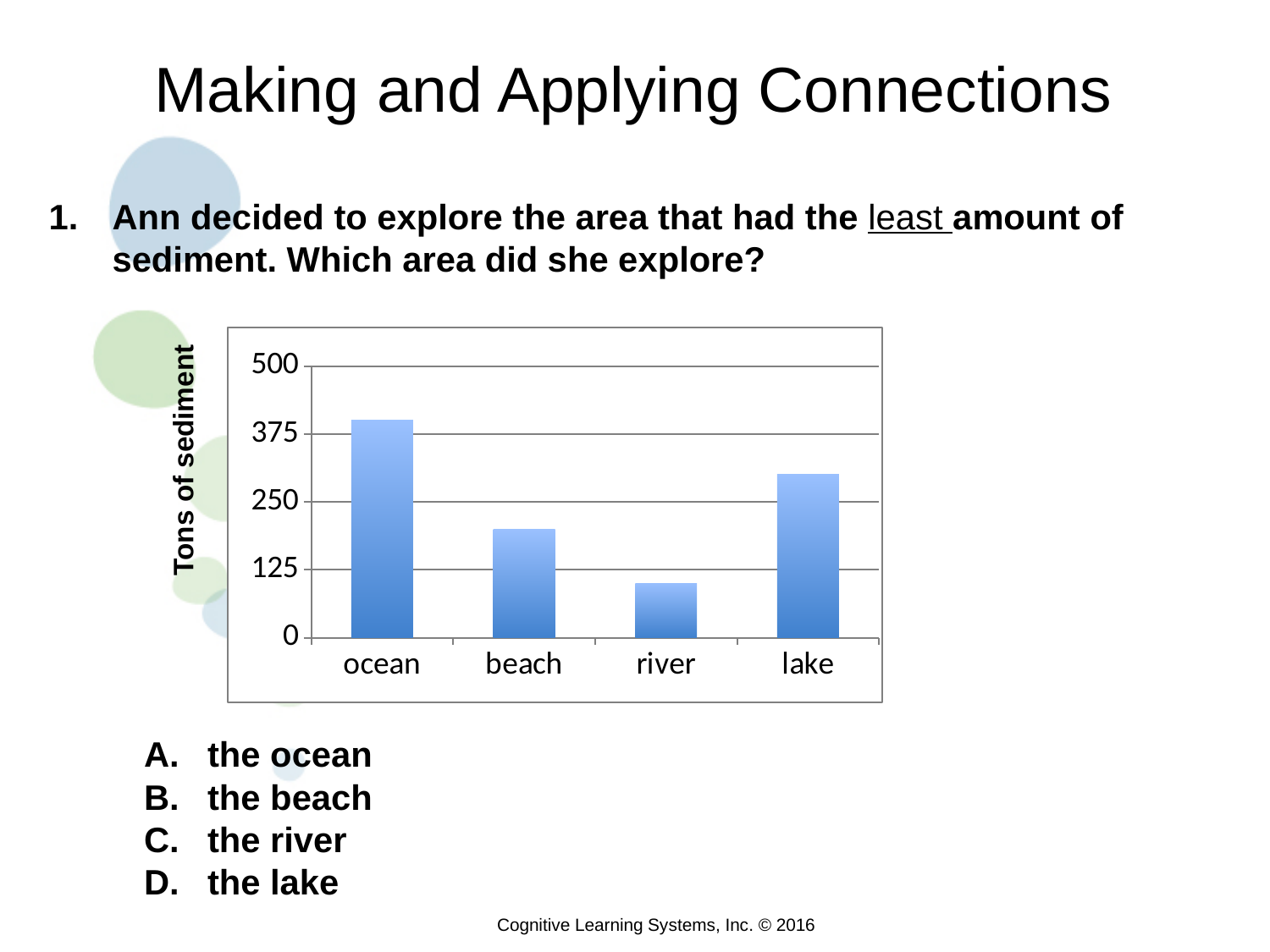
What is the highest value shown on the vertical axis of the chart? 500 Which has more tons of sediment, the beach or the lake? lake Is the value for ocean greater or less than 375? greater Which has more tons of sediment, the ocean or the river? ocean Which area has the highest tons of sediment? ocean What kind of chart is shown on the slide? bar chart Is the value for beach greater or less than 250? less Is the value for river greater or less than 125? less Which area has the lowest tons of sediment? river What is the label on the vertical axis of the chart? Tons of sediment How many categories are shown on the x axis of the chart? 4